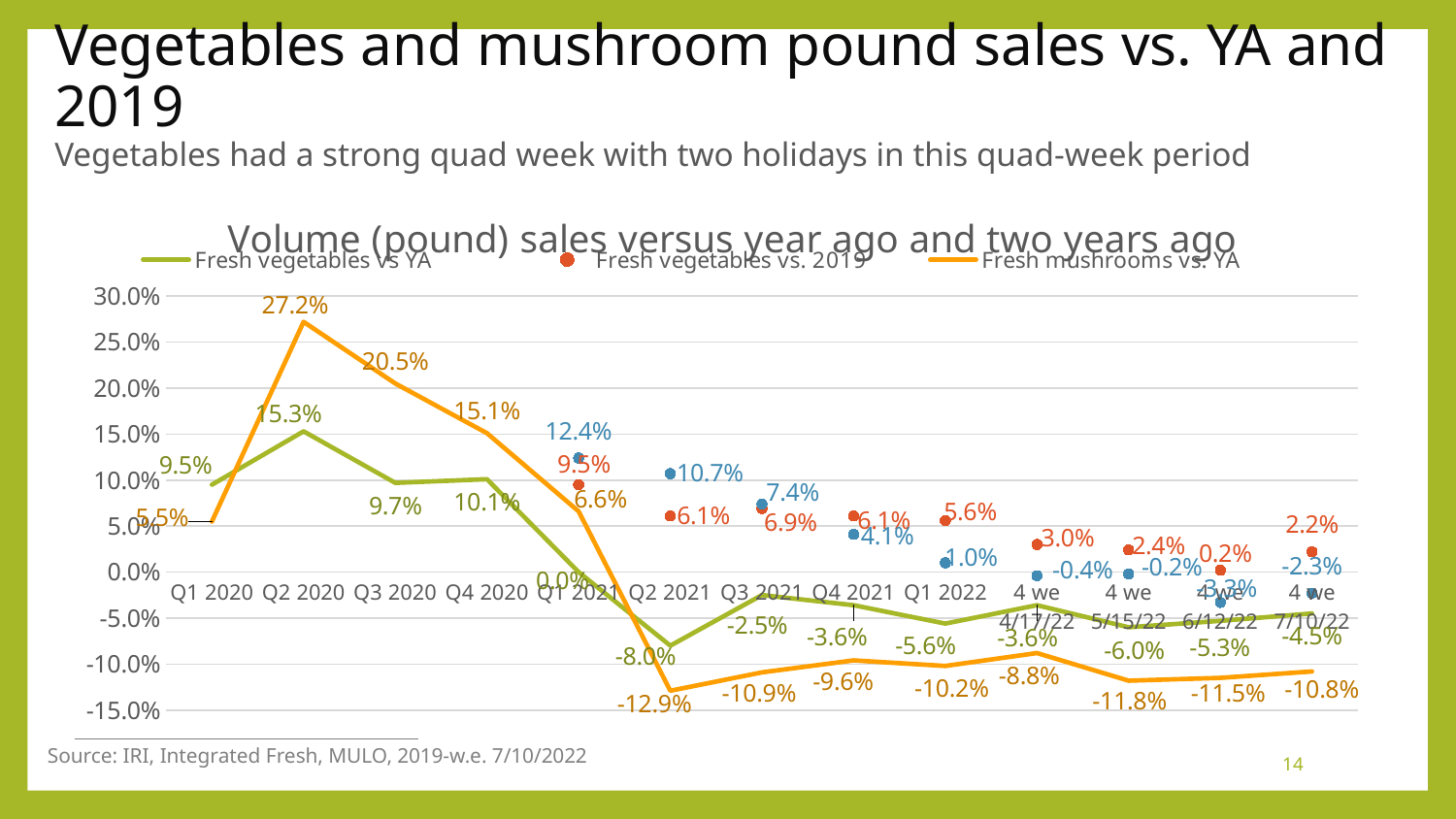
What kind of chart is shown on the slide? Line chart What is the difference between Fresh mushrooms vs. YA and Fresh vegetables vs YA in Q2 2020? 11.9 percentage points In which period is Fresh mushrooms vs. YA lowest? Q2 2021 In Q1 2020, which is larger: Fresh vegetables vs YA or Fresh mushrooms vs. YA? Fresh vegetables vs YA How many periods are shown on the x axis? 13 Does Fresh mushrooms vs. YA rise or fall from Q2 2020 to Q2 2021? Fall What is the value for Fresh vegetables vs. 2019 for the 4 weeks ending 7/10/22? 2.2% What is the value for Fresh mushrooms vs. YA in Q2 2020? 27.2% In which period is Fresh vegetables vs YA highest? Q2 2020 How many series does the chart legend list? 3 In which period is Fresh mushrooms vs. YA highest? Q2 2020 What is the value for Fresh vegetables vs YA in Q2 2021? -8.0%